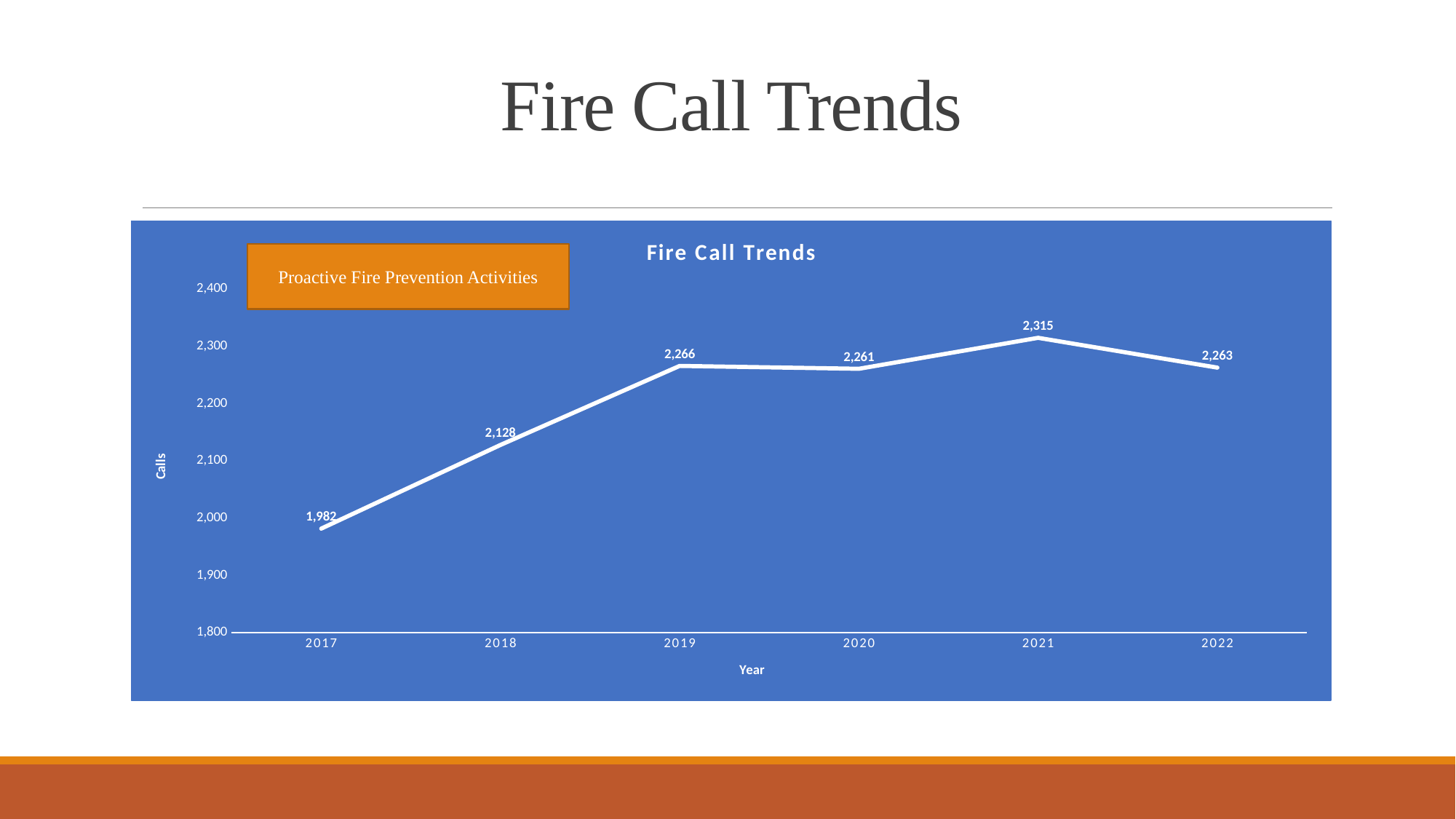
Which year has the lowest number of fire calls? 2017 What is the number of fire calls in 2021? 2,315 What kind of chart is shown on the slide? line chart What is the number of fire calls in 2017? 1,982 What is the label on the vertical axis of the chart? Calls What is the difference in fire calls between 2021 and 2022? 52 Which year has the highest number of fire calls? 2021 What is the number of fire calls in 2019? 2,266 How many years are plotted on the chart? 6 What is the difference in fire calls between 2018 and 2017? 146 Which year had more fire calls, 2018 or 2020? 2020 Is the value for 2017 greater or less than 2,000? less